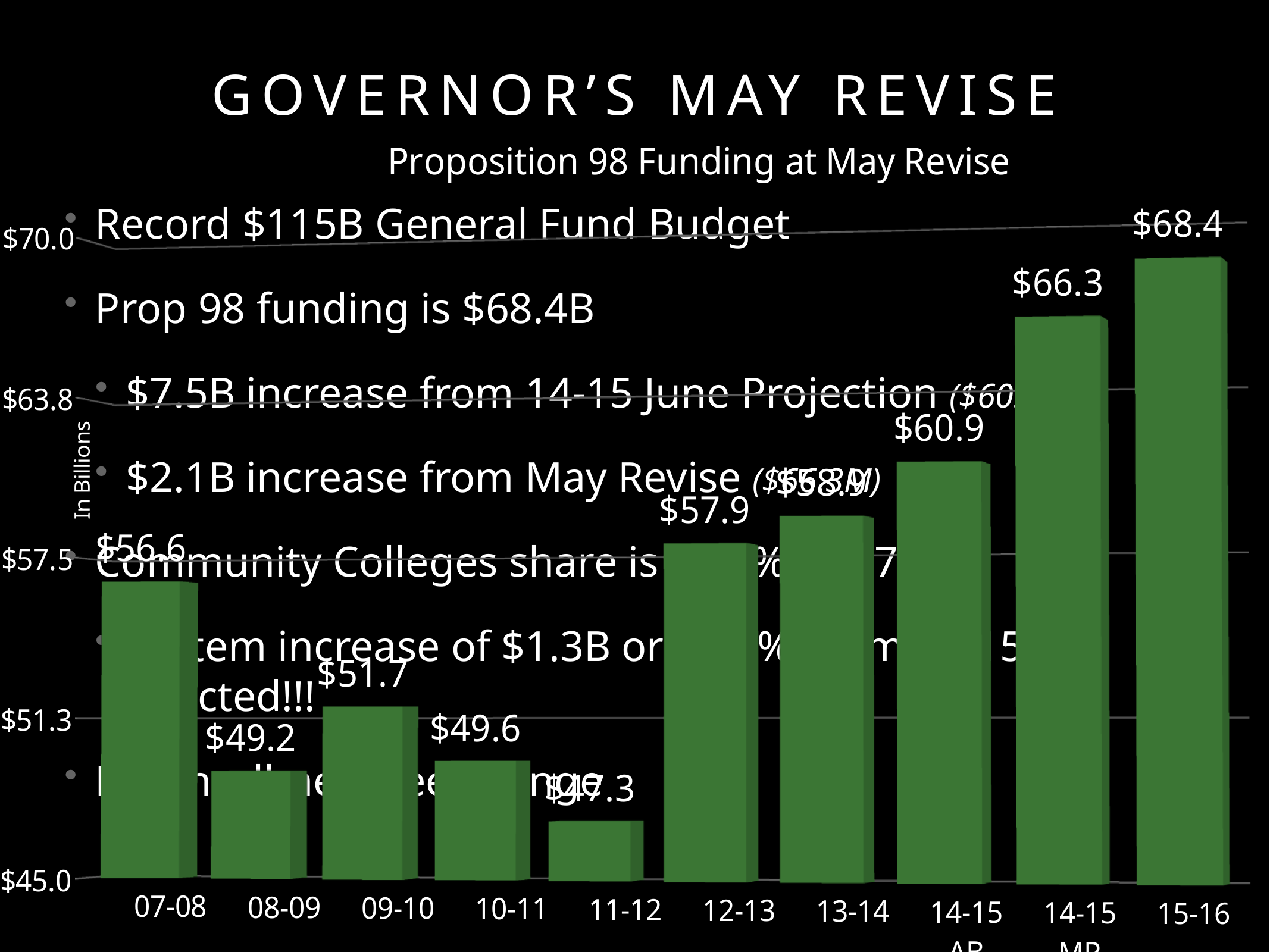
Which fiscal year has the highest value? 15-16 What is the label on the vertical axis of the chart? In Billions What kind of chart is shown on the slide? bar chart What is the value for 15-16? $68.4 What is the value for 07-08? $56.6 Is the value for 10-11 greater or less than $51.3? less Which fiscal year has the lowest value? 11-12 What is the difference between the values for 15-16 and 07-08? $11.8 How many bars (fiscal years) are plotted in the chart? 10 What is the value for 12-13? $57.9 What is the title of the chart? Proposition 98 Funding at May Revise What is the value for 09-10? $51.7